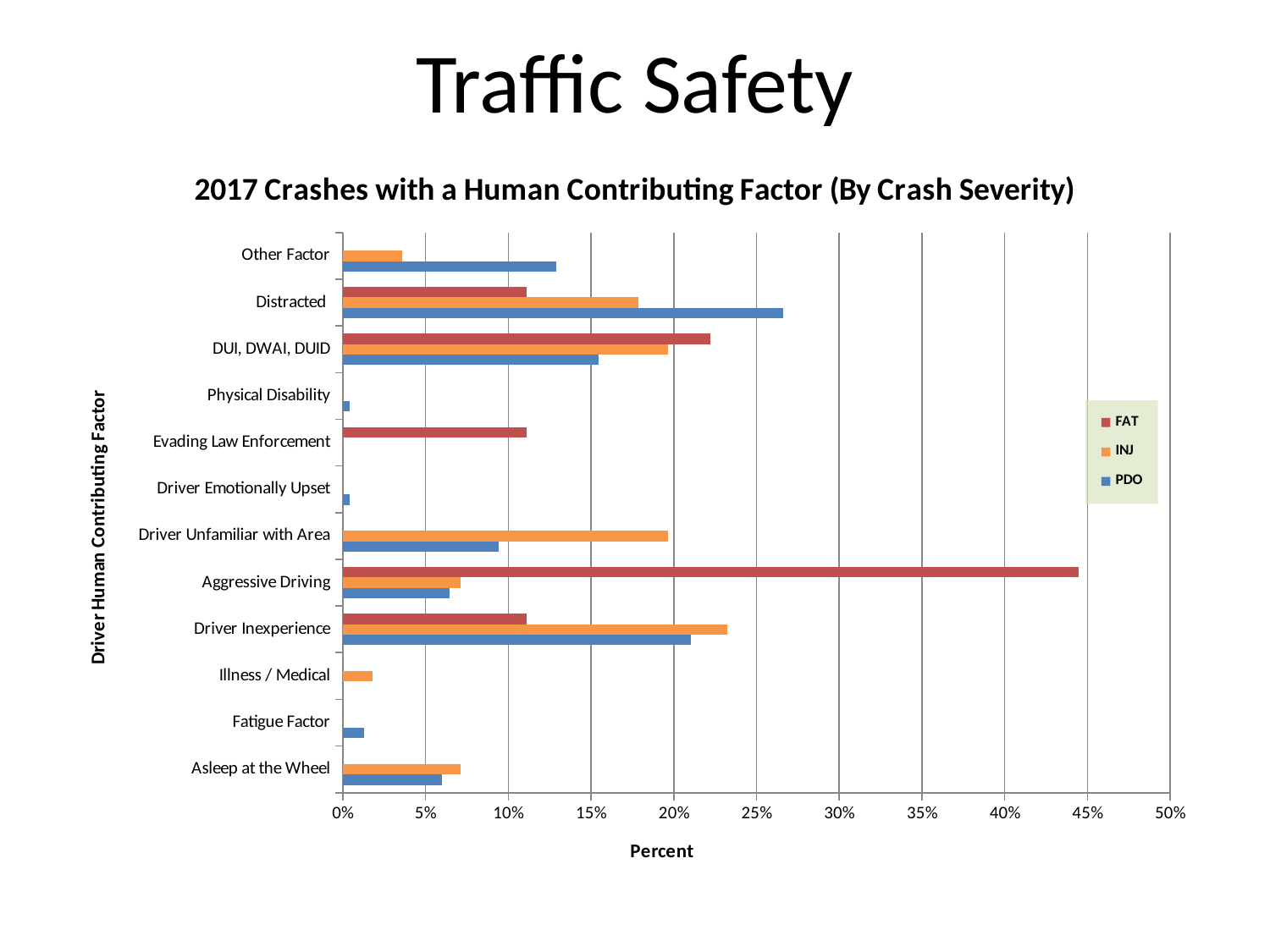
Is the FAT value for Aggressive Driving greater or less than 40%? greater Which category has the highest FAT value? Aggressive Driving How many driver human contributing factor categories are shown on the chart? 12 What kind of chart is shown on the slide? Bar chart How many series does the legend list? 3 For Distracted, which is larger: the PDO value or the INJ value? PDO Which category has the highest PDO value? Distracted Is the PDO value for Distracted greater or less than 25%? greater Is the PDO value for Other Factor greater or less than 10%? greater Which category has the highest INJ value? Driver Inexperience What is the title of the chart? 2017 Crashes with a Human Contributing Factor (By Crash Severity)